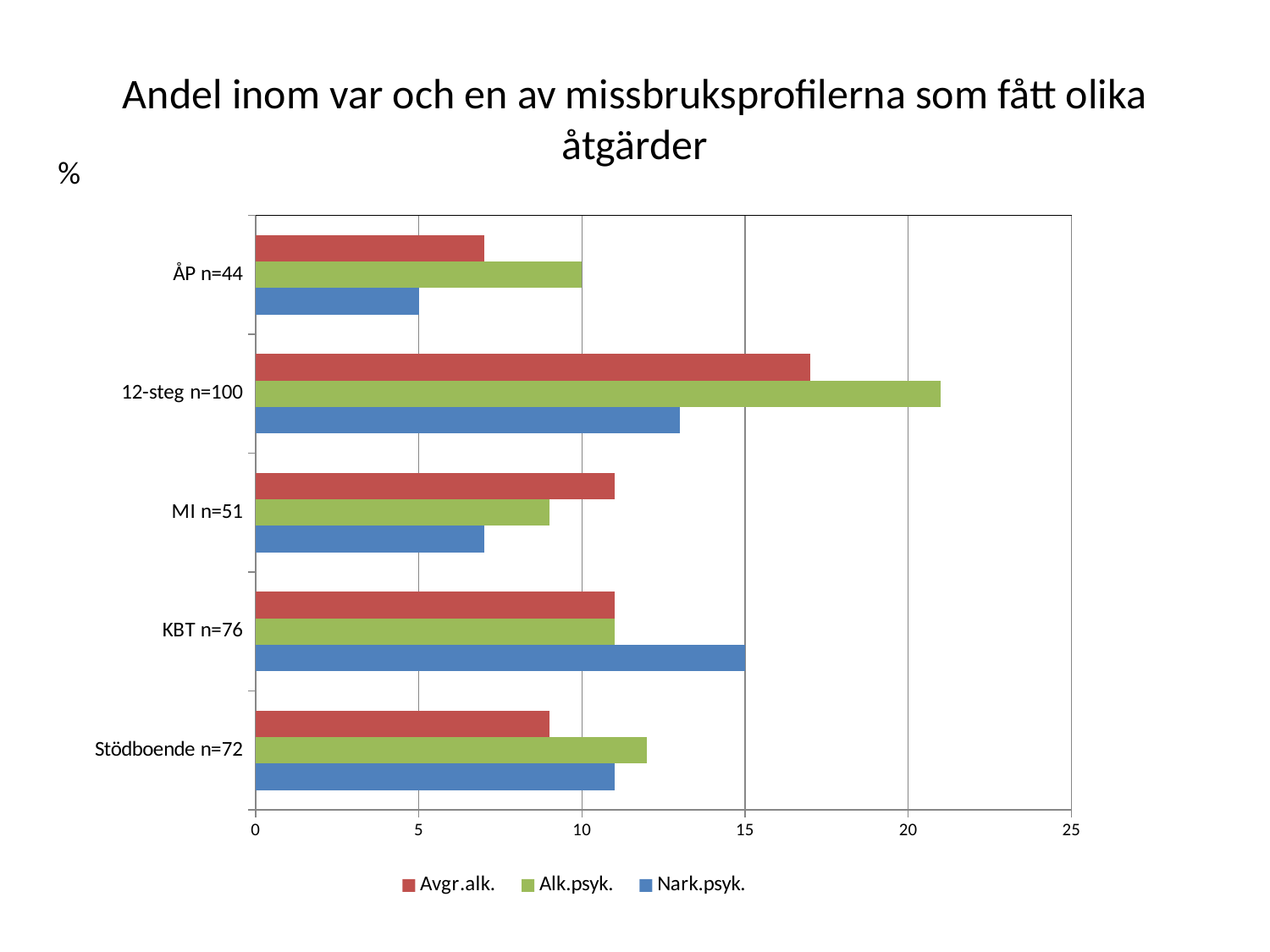
Which category has the highest Alk.psyk. value? 12-steg n=100 How many series does the legend list? 3 What is the value for Nark.psyk. in the ÅP n=44 category? 5 Which series is shown in green in the legend? Alk.psyk. In the KBT n=76 category, which is larger: Nark.psyk. or Avgr.alk.? Nark.psyk. What is the difference between the Alk.psyk. and Nark.psyk. values for ÅP n=44? 5 Which category has the lowest Nark.psyk. value? ÅP n=44 What is the value for Alk.psyk. in the ÅP n=44 category? 10 What is the value for Nark.psyk. in the KBT n=76 category? 15 How many categories (missbruksprofiler) are shown on the y axis? 5 Is the Avgr.alk. value for 12-steg n=100 greater or less than 15? greater What kind of chart is shown on the slide? bar chart